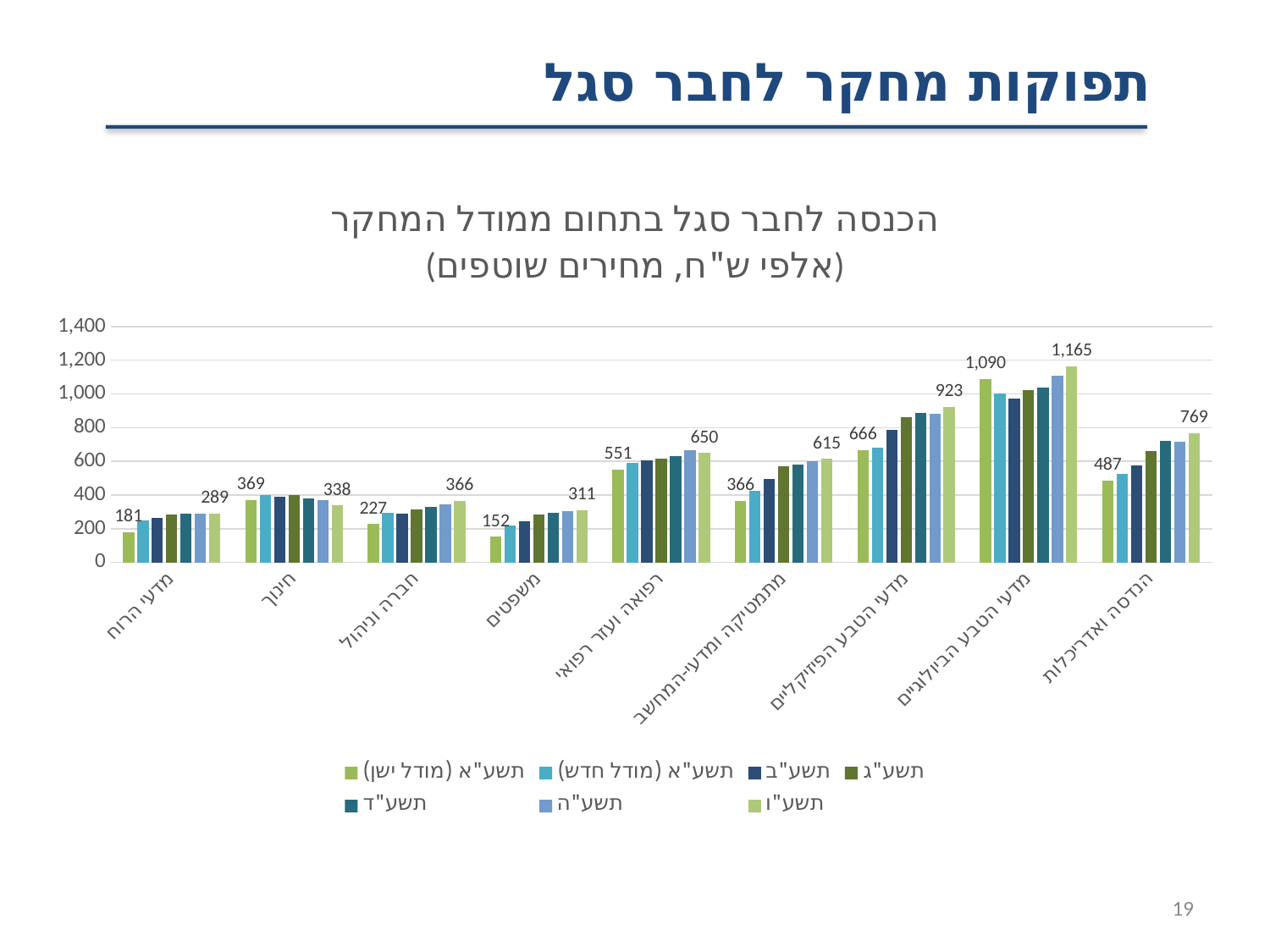
How many categories are shown on the x axis? 9 What is the value for מדעי הרוח in the תשע"א (מודל ישן) series? 181 What is the value for מתמטיקה ומדעי-המחשב in the תשע"ו series? 615 Which category has the lowest value in the תשע"א (מודל ישן) series? משפטים How many series does the legend list? 7 What is the difference between the תשע"ו and תשע"א (מודל ישן) values for מדעי הטבע הפיזיקליים? 257 Is the תשע"ה value for מדעי הטבע הביולוגיים greater or less than 1,000? greater What is the value for הנדסה ואדריכלות in the תשע"א (מודל ישן) series? 487 Which category has the highest value in the תשע"ו series? מדעי הטבע הביולוגיים What kind of chart is shown on the slide? bar chart Which is larger for חינוך: the תשע"א (מודל ישן) value or the תשע"ו value? תשע"א (מודל ישן) What is the value for מדעי הטבע הביולוגיים in the תשע"ו series? 1,165